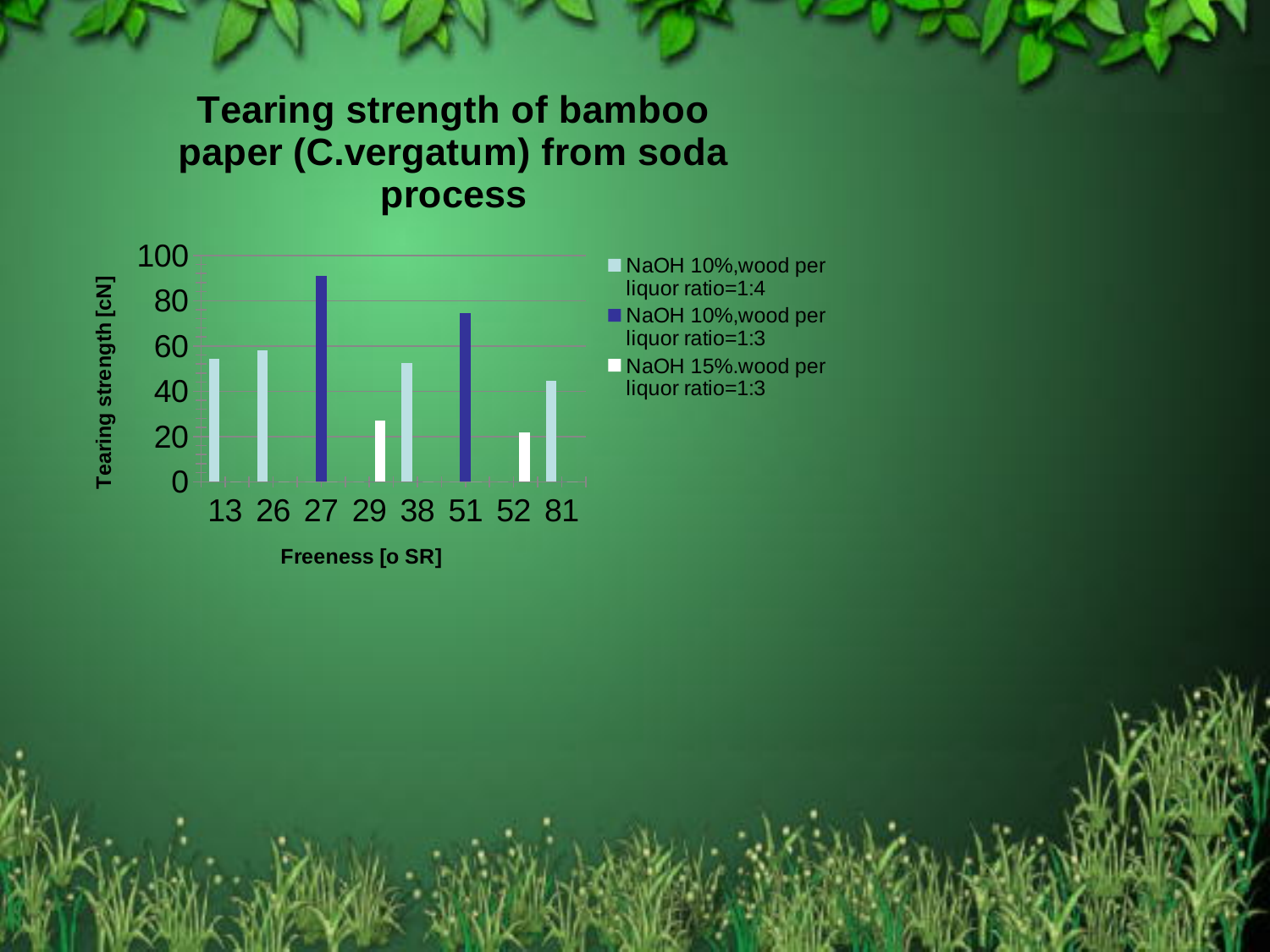
How many freeness categories are shown on the x axis? 8 At which freeness value is the tearing strength lowest? 52 Is the tearing strength at freeness 27 greater or less than 80? greater Is the tearing strength at freeness 51 greater or less than 60? greater Which has the larger tearing strength, freeness 27 or freeness 51? 27 Is the tearing strength at freeness 29 greater or less than 40? less How many series does the legend list? 3 Which has the larger tearing strength, freeness 81 or freeness 52? 81 At which freeness value is the tearing strength highest? 27 What kind of chart is shown on the slide? bar chart What is the title of the y axis? Tearing strength [cN]